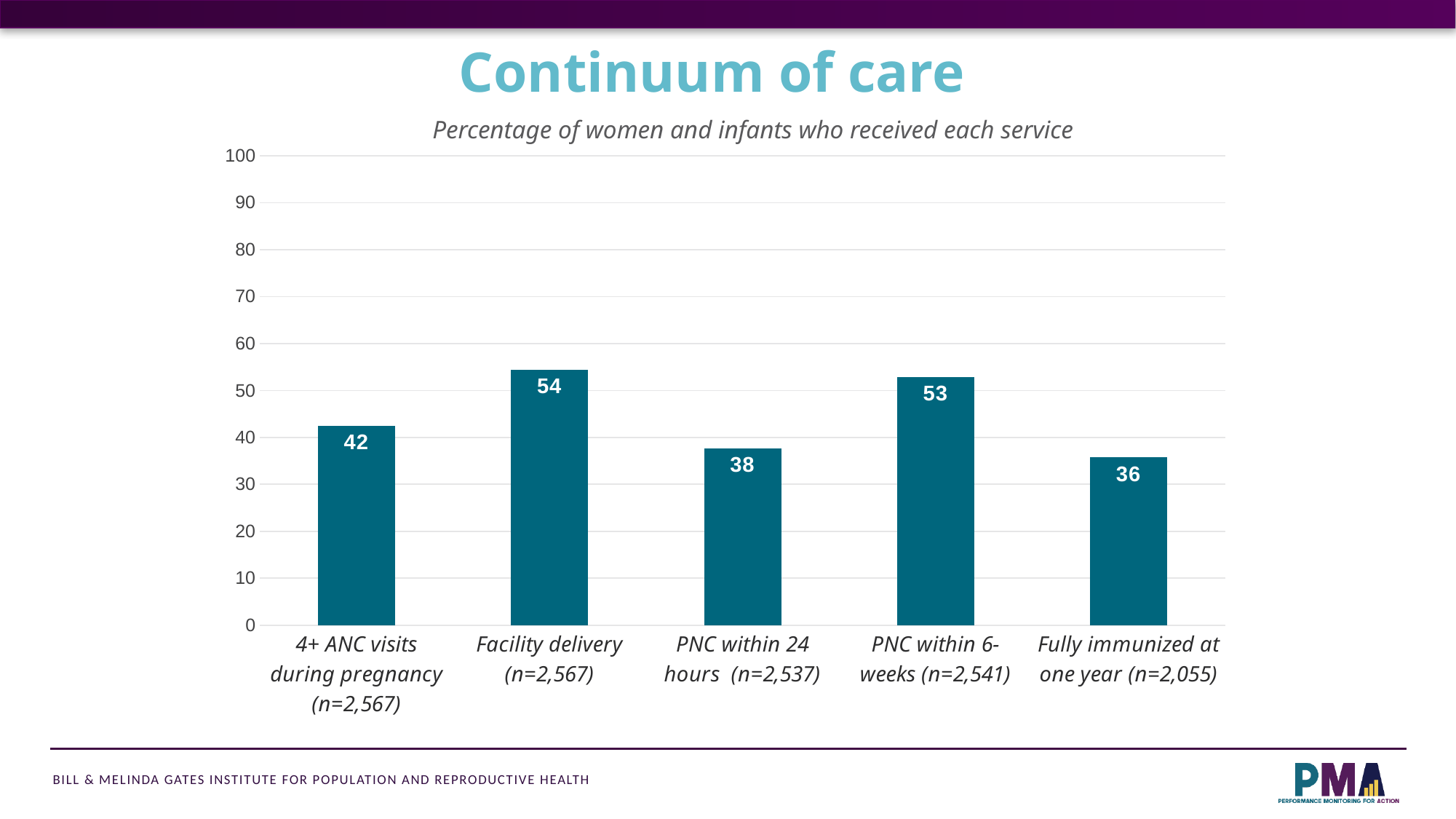
How many services are shown on the chart? 5 Which service has the lowest percentage? Fully immunized at one year What is the value for PNC within 24 hours? 38 What is the value for Facility delivery? 54 Which is larger, the value for 4+ ANC visits during pregnancy or the value for PNC within 6-weeks? PNC within 6-weeks What is the sample size (n) shown for PNC within 24 hours? 2,537 Which service has the highest percentage? Facility delivery What percentage of women had 4+ ANC visits during pregnancy? 42 What is the difference between the values for Facility delivery and PNC within 24 hours? 16 Is the value for PNC within 6-weeks greater or less than 50? greater What is the value for Fully immunized at one year? 36 What kind of chart is shown on the slide? Bar chart